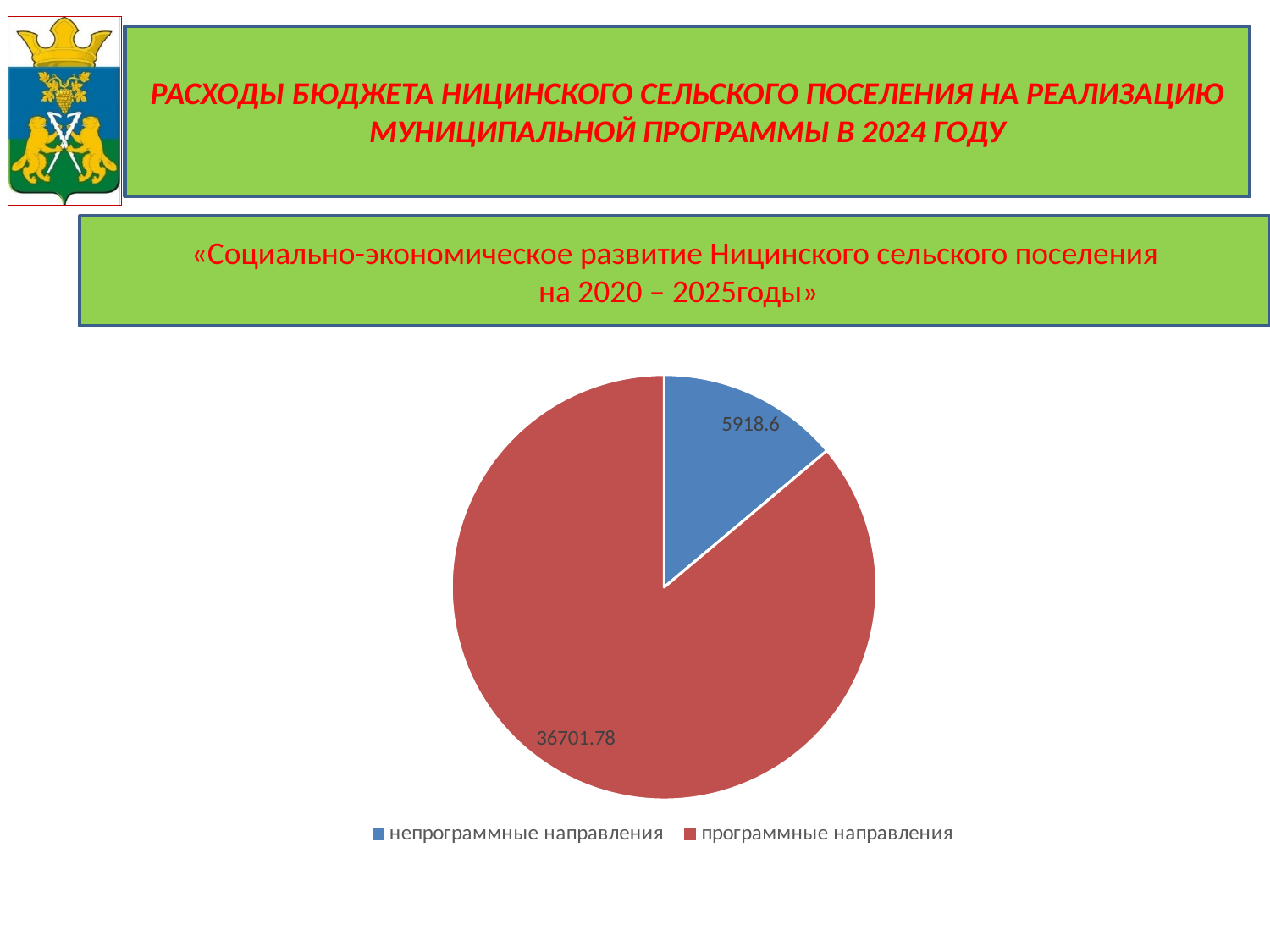
What is the difference between программные направления and непрограммные направления? 30783.18 How many entries does the legend list? 2 Which is larger: непрограммные направления or программные направления? программные направления What colour is the slice for непрограммные направления? blue Which category has the smallest slice of the pie? непрограммные направления What is the value for программные направления? 36701.78 What is the value for непрограммные направления? 5918.6 What type of chart is shown on the slide? pie chart What is the total of the two slices in the pie chart? 42620.38 How many slices does the pie chart have? 2 Which category has the largest slice of the pie? программные направления